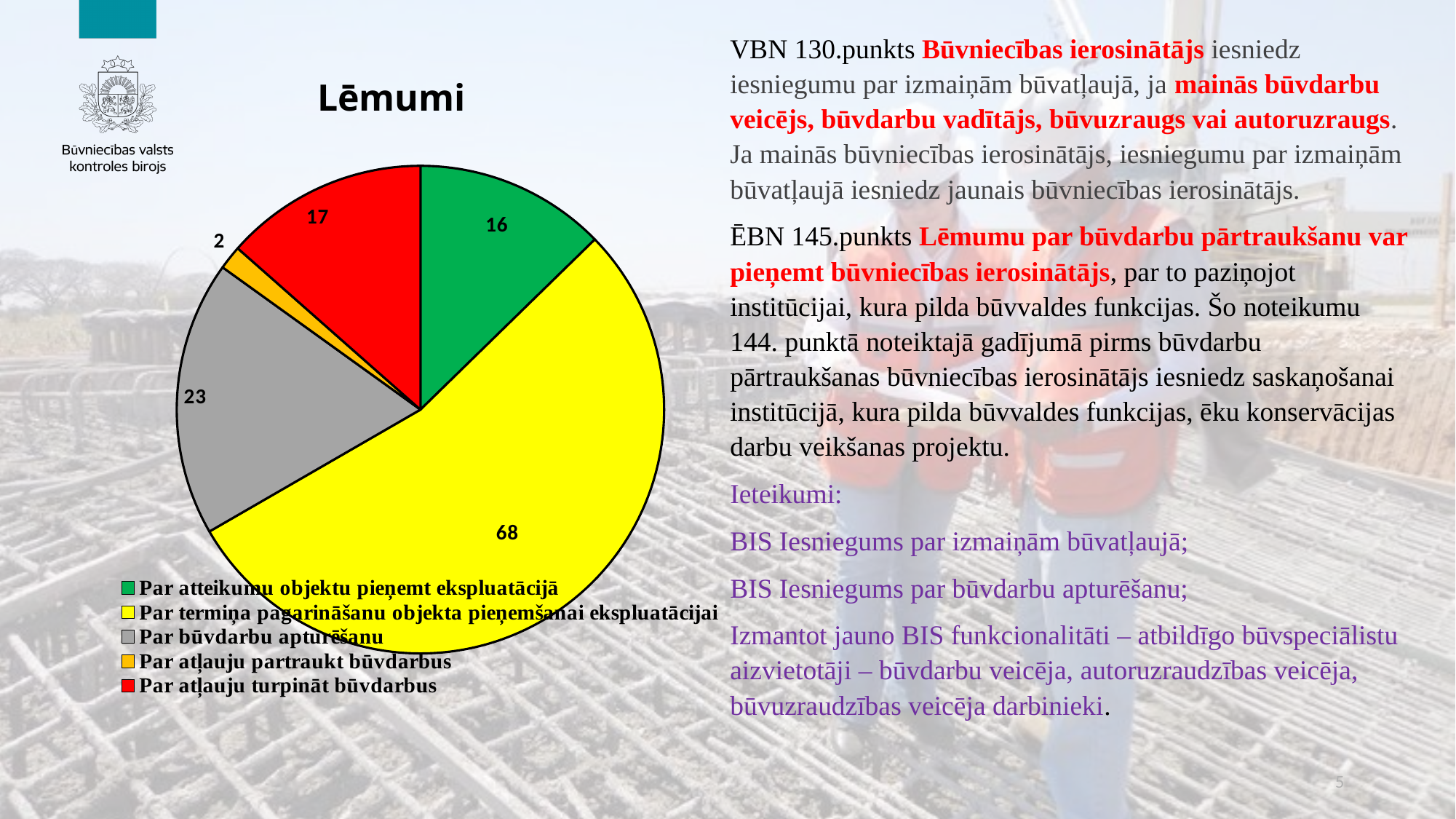
What is the value for "Par atteikumu objektu pieņemt ekspluatācijā"? 16 What is the value for "Par atļauju turpināt būvdarbus"? 17 Which is larger: the value for "Par atļauju turpināt būvdarbus" or "Par atteikumu objektu pieņemt ekspluatācijā"? Par atļauju turpināt būvdarbus What is the value for "Par termiņa pagarināšanu objekta pieņemšanai ekspluatācijai"? 68 What colour is the slice for "Par būvdarbu apturēšanu"? gray Which category has the smallest slice? Par atļauju partraukt būvdarbus What type of chart is shown on the slide? pie chart How many slices does the pie chart have? 5 What is the title of the chart? Lēmumi What is the value for "Par būvdarbu apturēšanu"? 23 What is the difference between the values for "Par termiņa pagarināšanu objekta pieņemšanai ekspluatācijai" and "Par būvdarbu apturēšanu"? 45 Which category has the largest slice? Par termiņa pagarināšanu objekta pieņemšanai ekspluatācijai